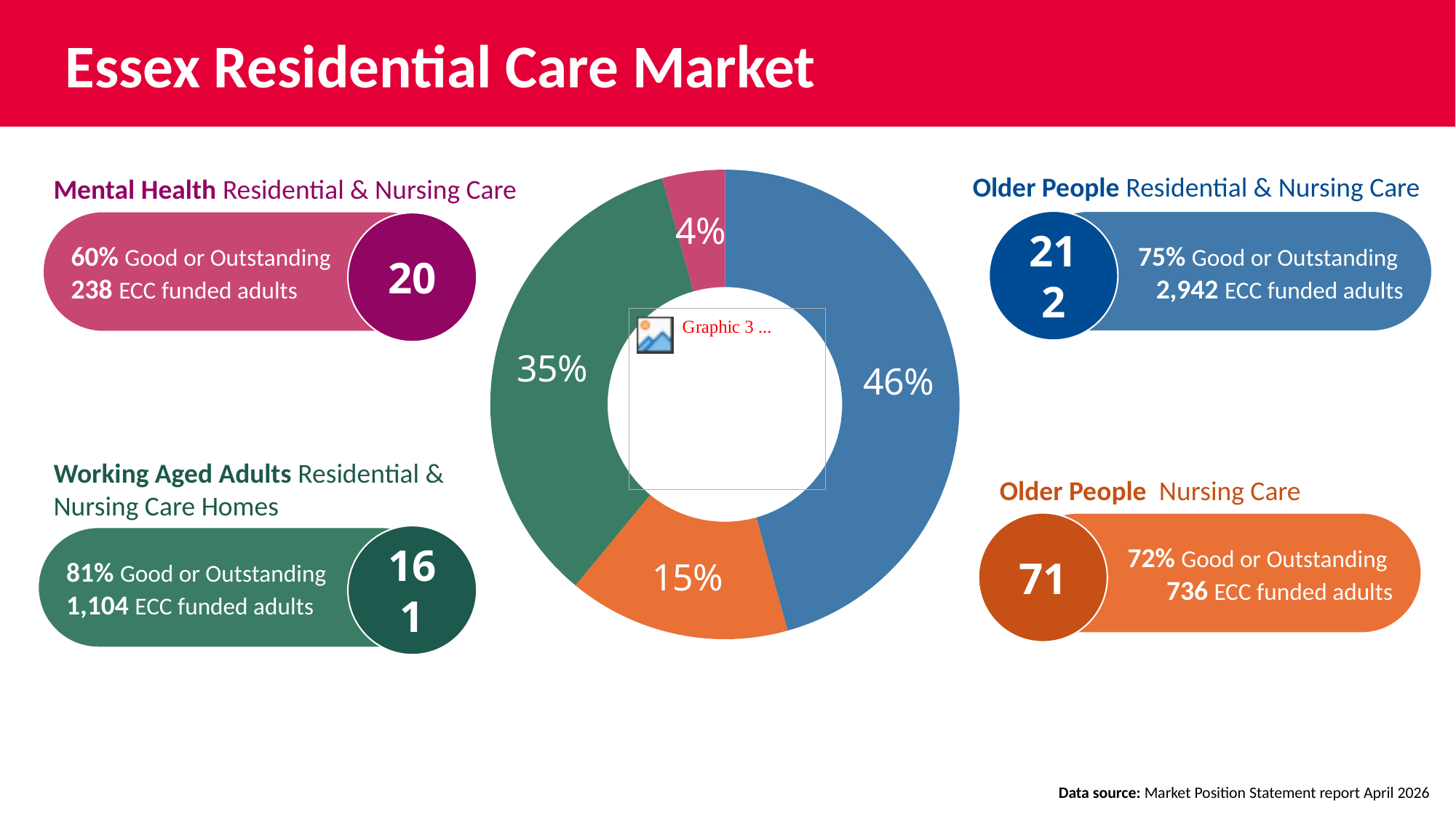
What percentage is shown on the green slice of the donut chart? 35% How many slices does the donut chart have? 4 What is the largest percentage shown on the donut chart? 46% What is the smallest percentage shown on the donut chart? 4% What is the difference in percentage points between the blue slice and the green slice of the donut chart? 11 What is the title of the slide containing the donut chart? Essex Residential Care Market What is the combined percentage of the orange and pink slices of the donut chart? 19% Which slice of the donut chart is larger, the orange slice or the pink slice? Orange slice What percentage is shown on the blue slice of the donut chart? 46% What kind of chart is shown in the centre of the slide? Pie chart (donut) What percentage is shown on the pink slice of the donut chart? 4% What percentage is shown on the orange slice of the donut chart? 15%